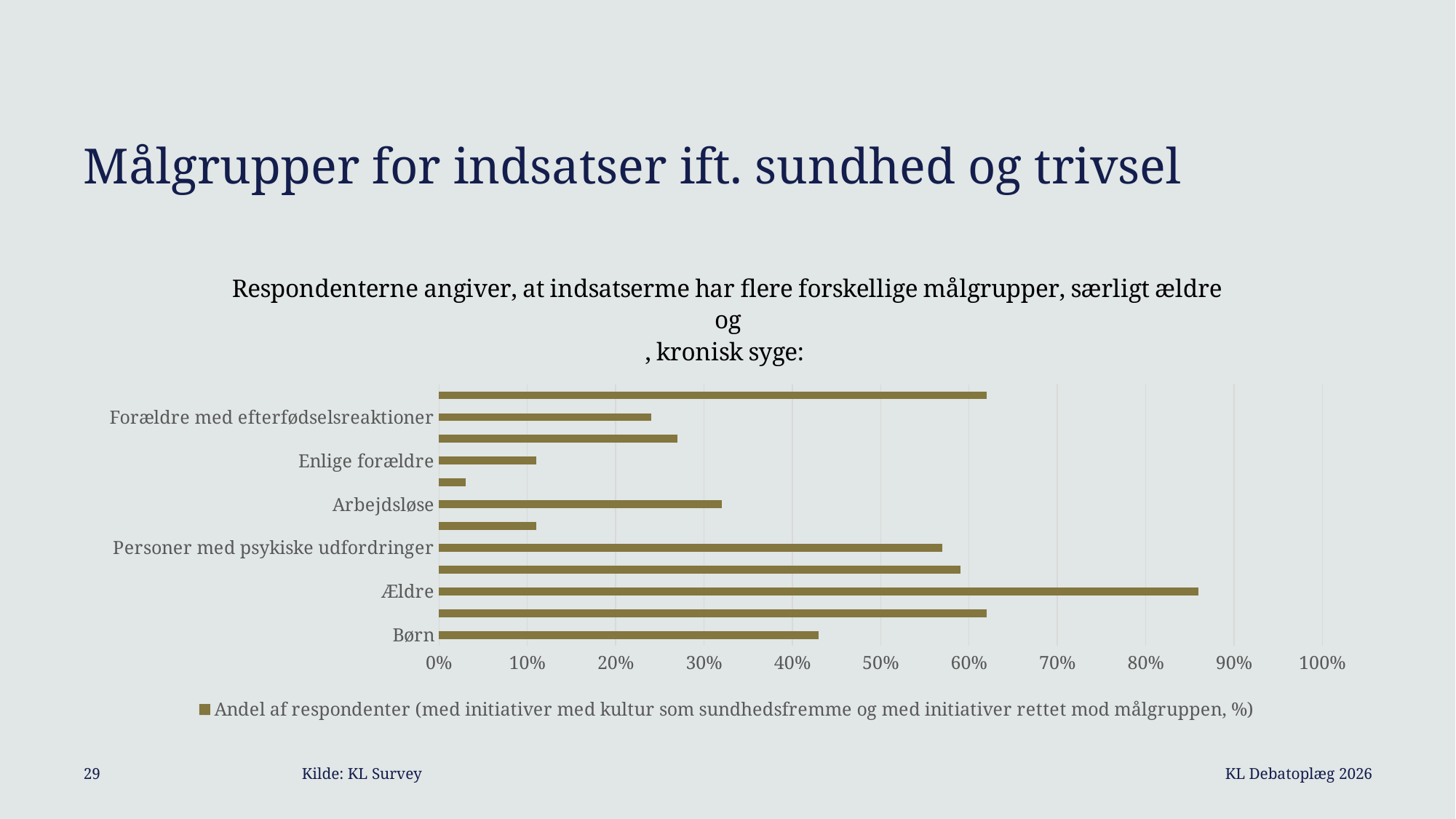
Which is larger, the value for Ældre or the value for Børn? Ældre Is the value for Personer med psykiske udfordringer greater or less than 50%? greater Is the value for Enlige forældre greater or less than 20%? less Is the value for Børn greater or less than 50%? less How many series does the chart legend list? 1 How many bars are plotted in the chart? 12 Which category has the highest value in the chart? Ældre What source is cited for the chart at the bottom of the slide? Kilde: KL Survey What kind of chart is shown on the slide? bar chart Among the labelled categories, which has the lowest value? Enlige forældre